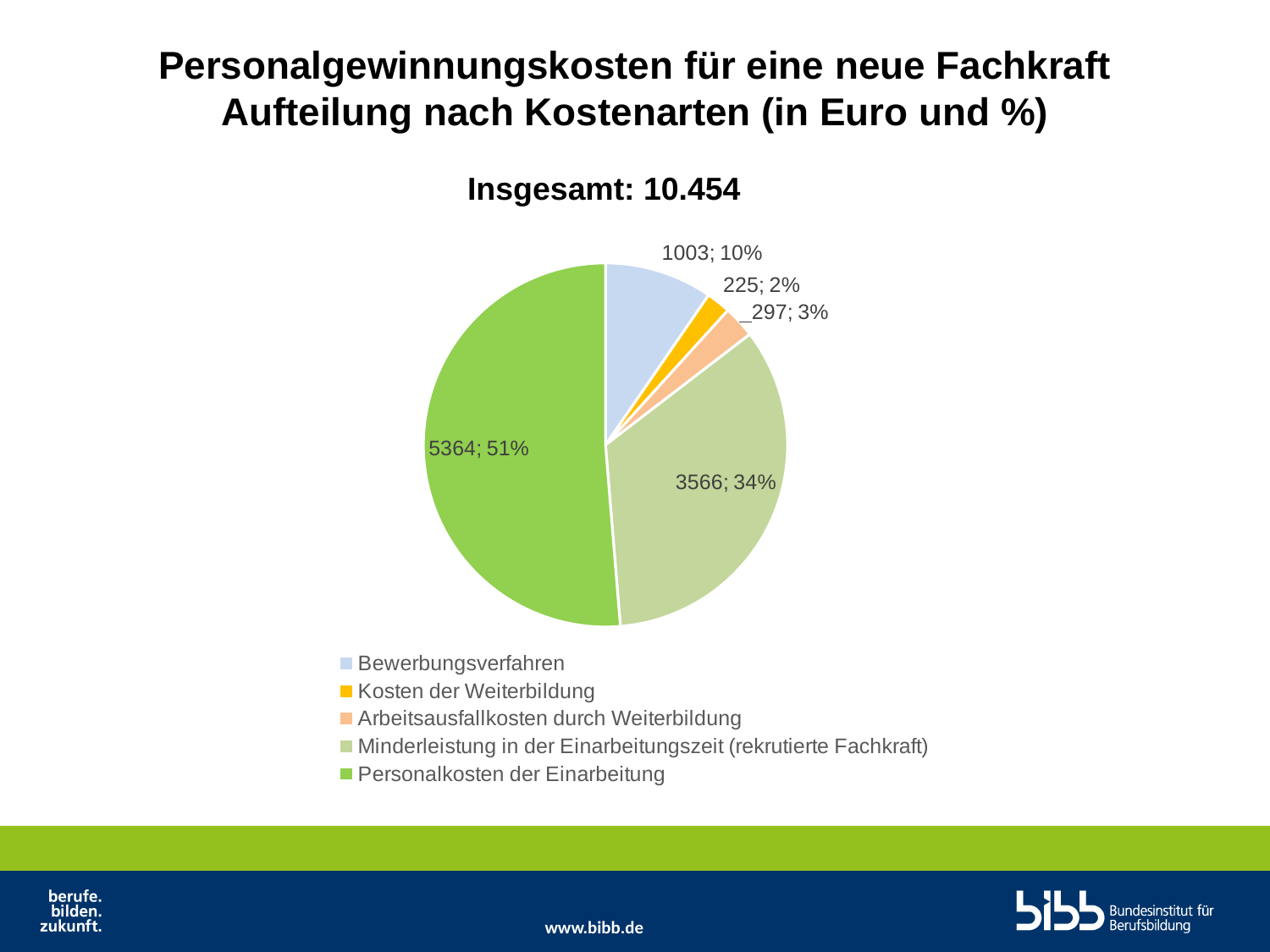
What is the value in Euro for Arbeitsausfallkosten durch Weiterbildung? 297 Which cost type has the smallest share of the pie? Kosten der Weiterbildung What kind of chart is shown on the slide? pie chart Which cost type has the largest share of the pie? Personalkosten der Einarbeitung What is the difference in Euro between Personalkosten der Einarbeitung and Minderleistung in der Einarbeitungszeit (rekrutierte Fachkraft)? 1798 What percentage share does Personalkosten der Einarbeitung have? 51% What total amount (Insgesamt) is stated above the chart? 10.454 What percentage share does Kosten der Weiterbildung have? 2% What is the value in Euro for Bewerbungsverfahren? 1003 What is the value in Euro for Minderleistung in der Einarbeitungszeit (rekrutierte Fachkraft)? 3566 How many cost types does the legend list? 5 Which is larger, the value for Bewerbungsverfahren or the value for Arbeitsausfallkosten durch Weiterbildung? Bewerbungsverfahren